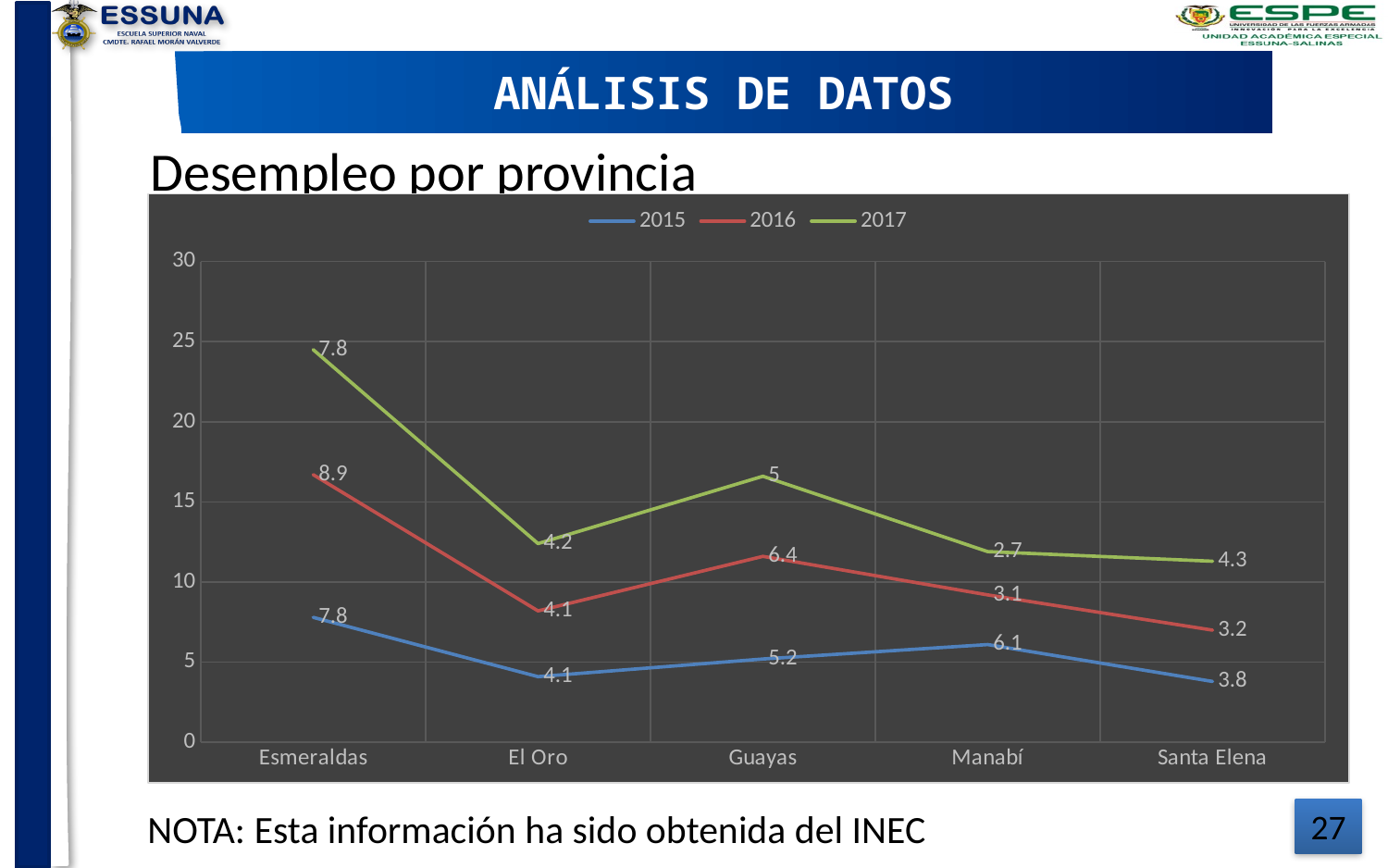
How many series does the legend list? 3 Which province has the lowest labelled value for 2017? Manabí Which is larger, the 2015 value for Manabí or the 2016 value for Manabí? 2015 (6.1) What is the title of the chart? Desempleo por provincia Which province has the highest labelled value for 2016? Esmeraldas What is the 2017 value for Santa Elena? 4.3 What is the 2015 value for Esmeraldas? 7.8 What kind of chart is shown on the slide? Line chart What is the difference between the 2015 values for Esmeraldas and Santa Elena? 4 How many provinces are shown on the x axis? 5 What is the 2016 value for Manabí? 3.1 What is the 2016 value for Guayas? 6.4